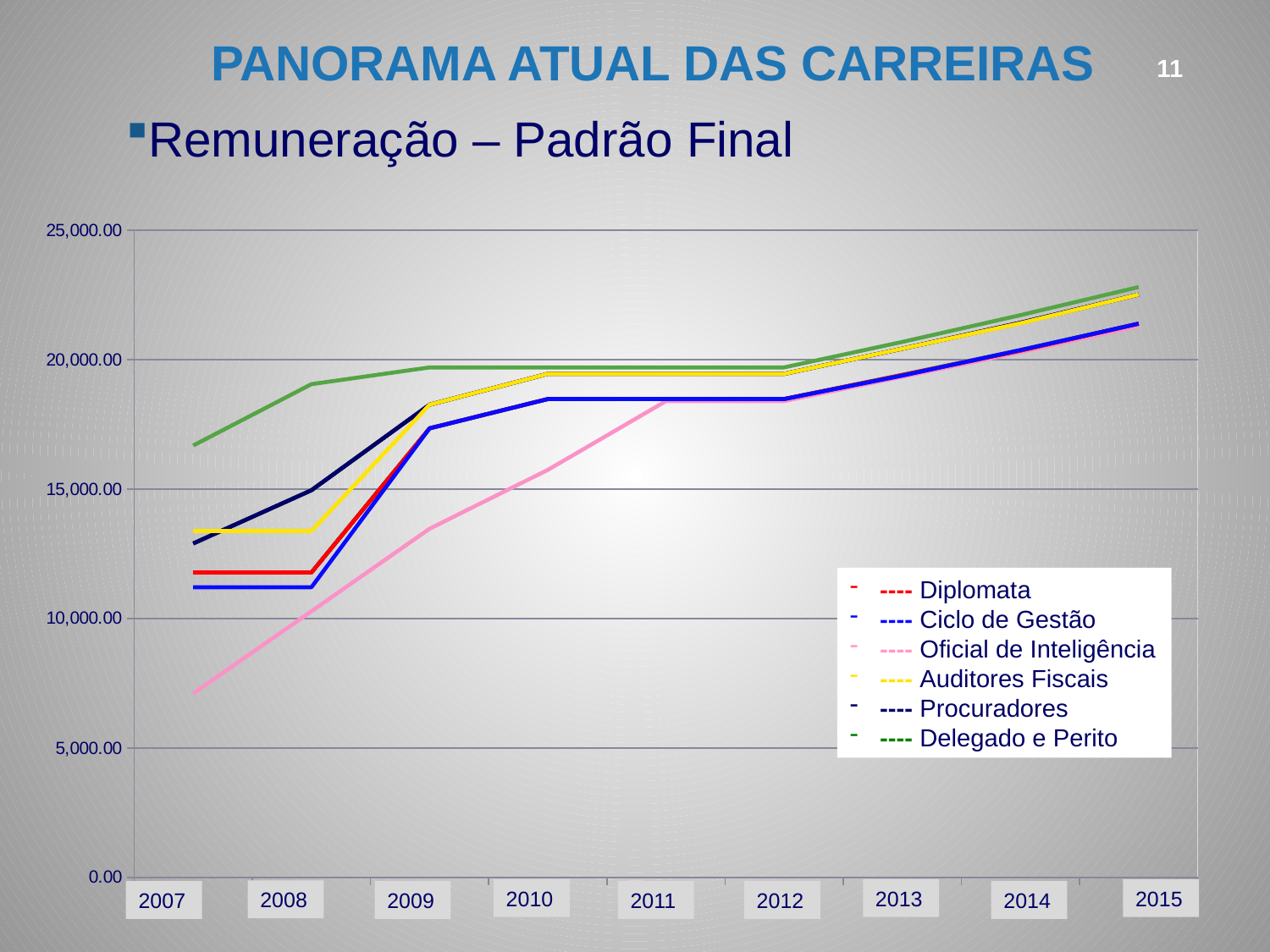
Which series has the lowest value in 2007? Oficial de Inteligência What kind of chart is shown on the slide? line chart Which series has the highest value in 2007? Delegado e Perito What colour is the Diplomata line in the legend? red Is the value for Delegado e Perito in 2015 greater or less than 20,000.00? greater In 2008, which is higher: Procuradores or Auditores Fiscais? Procuradores Is the value for Oficial de Inteligência in 2007 greater or less than 10,000.00? less How many series does the legend list? 6 Does the Oficial de Inteligência line rise or fall from 2007 to 2015? rise Is the value for Ciclo de Gestão in 2007 greater or less than 10,000.00? greater How many years are shown along the x axis? 9